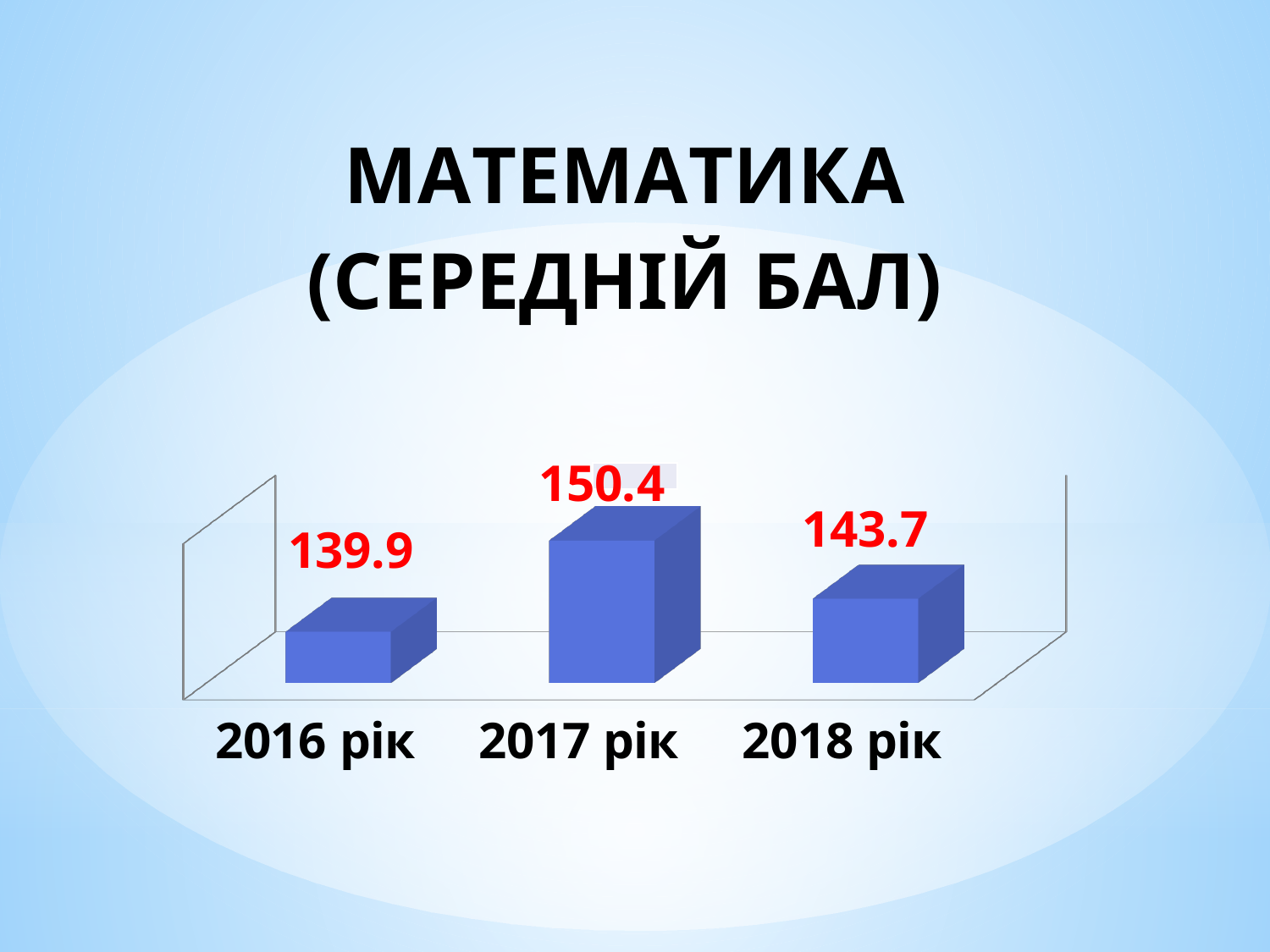
What kind of chart is shown on the slide? bar chart Which year has the highest value? 2017 рік How many categories are shown on the chart? 3 What is the value for 2016 рік? 139.9 What is the difference between the values for 2017 рік and 2016 рік? 10.5 What is the value for 2017 рік? 150.4 Which is larger, the value for 2018 рік or the value for 2016 рік? 2018 рік Which year has the lowest value? 2016 рік What is the difference between the values for 2017 рік and 2018 рік? 6.7 What is the title of the slide? МАТЕМАТИКА (СЕРЕДНІЙ БАЛ) What is the value for 2018 рік? 143.7 Does the value rise or fall from 2017 рік to 2018 рік? fall